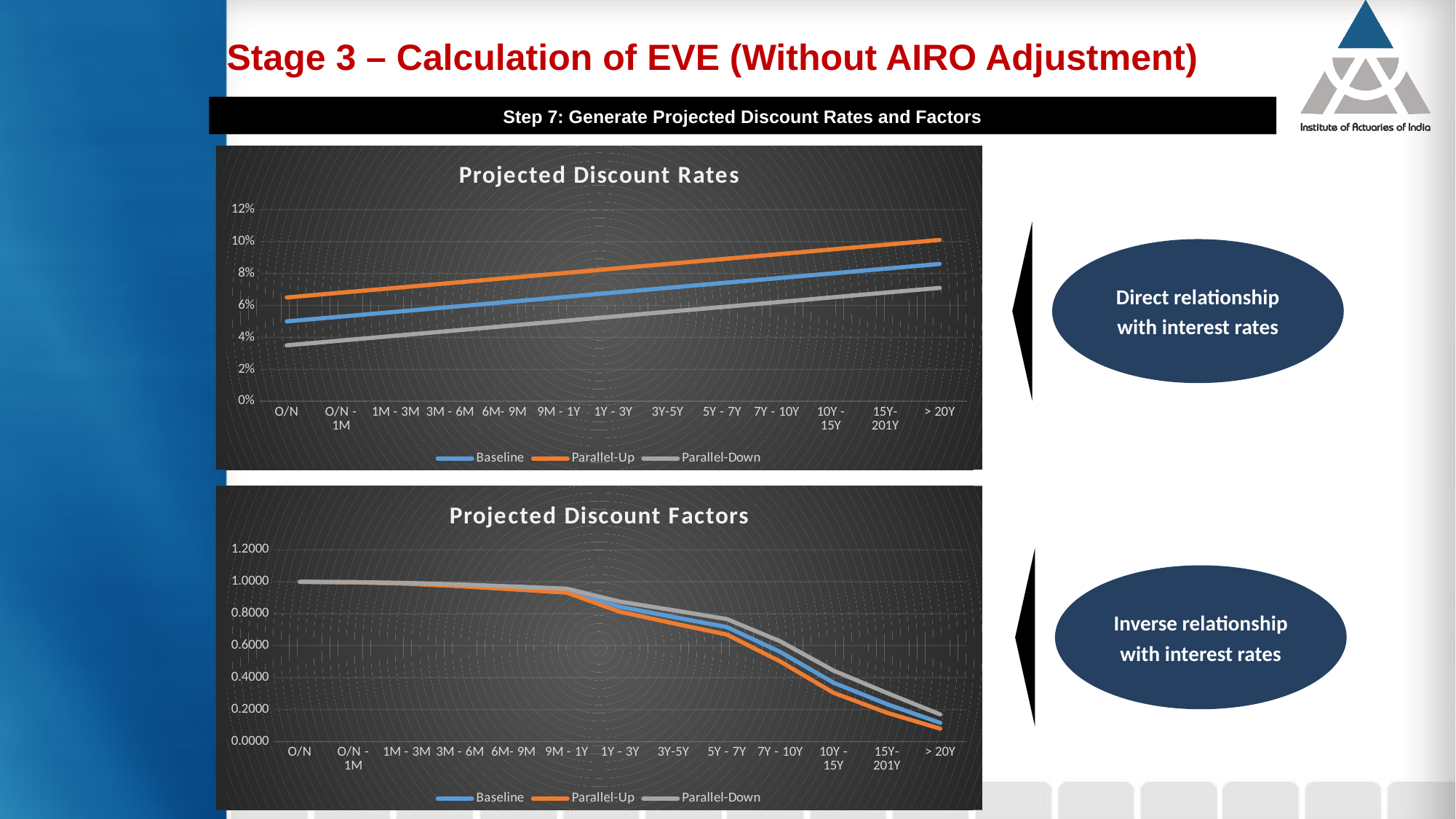
In the 'Projected Discount Factors' chart, is the Parallel-Up value at > 20Y greater or less than 0.2000? less How many categories are shown on the x axis of the 'Projected Discount Rates' chart? 13 In the 'Projected Discount Rates' chart, do the values rise or fall along the x axis from O/N to > 20Y? Rise In the 'Projected Discount Rates' chart, is the Parallel-Down value at O/N greater or less than 4%? less What type of chart is the 'Projected Discount Rates' chart? Line chart How many series does the legend of the 'Projected Discount Factors' chart list? 3 In the 'Projected Discount Rates' chart, which series is higher at > 20Y: Parallel-Up or Parallel-Down? Parallel-Up In the 'Projected Discount Factors' chart, do the values rise or fall along the x axis from O/N to > 20Y? Fall In the 'Projected Discount Rates' chart, is the Baseline value at > 20Y greater or less than 8%? greater In the 'Projected Discount Factors' chart, which series is higher at > 20Y: Parallel-Up or Parallel-Down? Parallel-Down